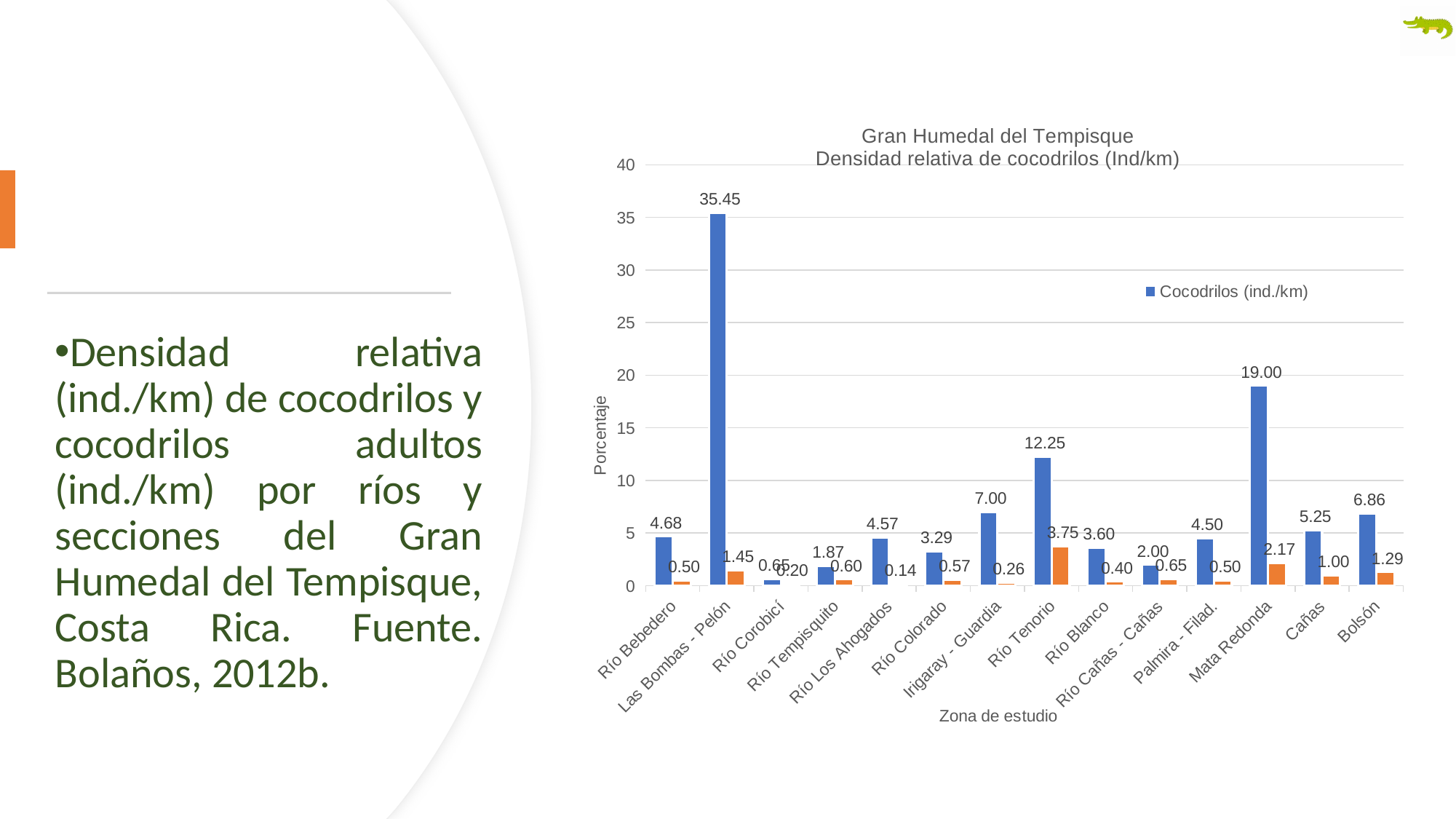
How many series does the legend list? 1 What is the label of the y axis? Porcentaje How many zonas de estudio are shown on the x axis? 14 What kind of chart is shown on the slide? bar chart Which has a higher Cocodrilos (ind./km) value, Río Tenorio or Mata Redonda? Mata Redonda What is the Cocodrilos (ind./km) value for Mata Redonda? 19.00 Which zona de estudio has the highest Cocodrilos (ind./km) value? Las Bombas - Pelón What is the Cocodrilos (ind./km) value for Río Tenorio? 12.25 What is the value of the orange bar for Río Tenorio? 3.75 Is the Cocodrilos (ind./km) value for Las Bombas - Pelón greater or less than 30? greater What is the difference between the Cocodrilos (ind./km) values for Las Bombas - Pelón and Mata Redonda? 16.45 Which zona de estudio has the lowest Cocodrilos (ind./km) value? Río Corobicí